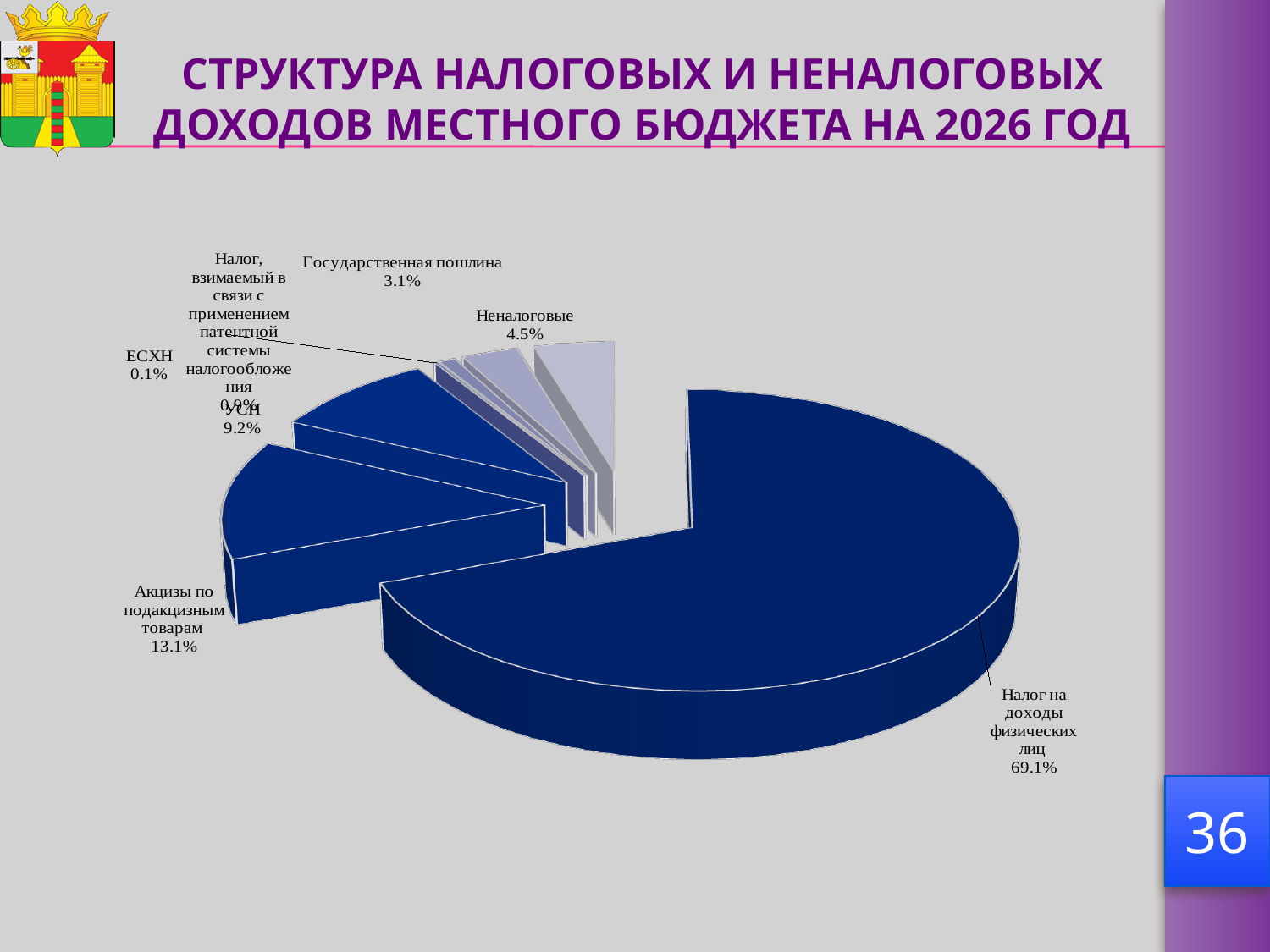
Which is larger: Неналоговые or Государственная пошлина? Неналоговые What is the value for Неналоговые? 4.5% What share of the pie does Налог на доходы физических лиц account for? 69.1% How many slices does the pie chart have? 7 What is the value shown for Акцизы по подакцизным товарам? 13.1% What is the value shown for ЕСХН? 0.1% What type of chart is shown on the slide? Pie chart Which category has the smallest share of the pie? ЕСХН What is the difference between the shares of Акцизы по подакцизным товарам and УСН? 3.9% What share is shown for Государственная пошлина? 3.1% Which category has the largest share of the pie? Налог на доходы физических лиц What percentage is shown for УСН? 9.2%